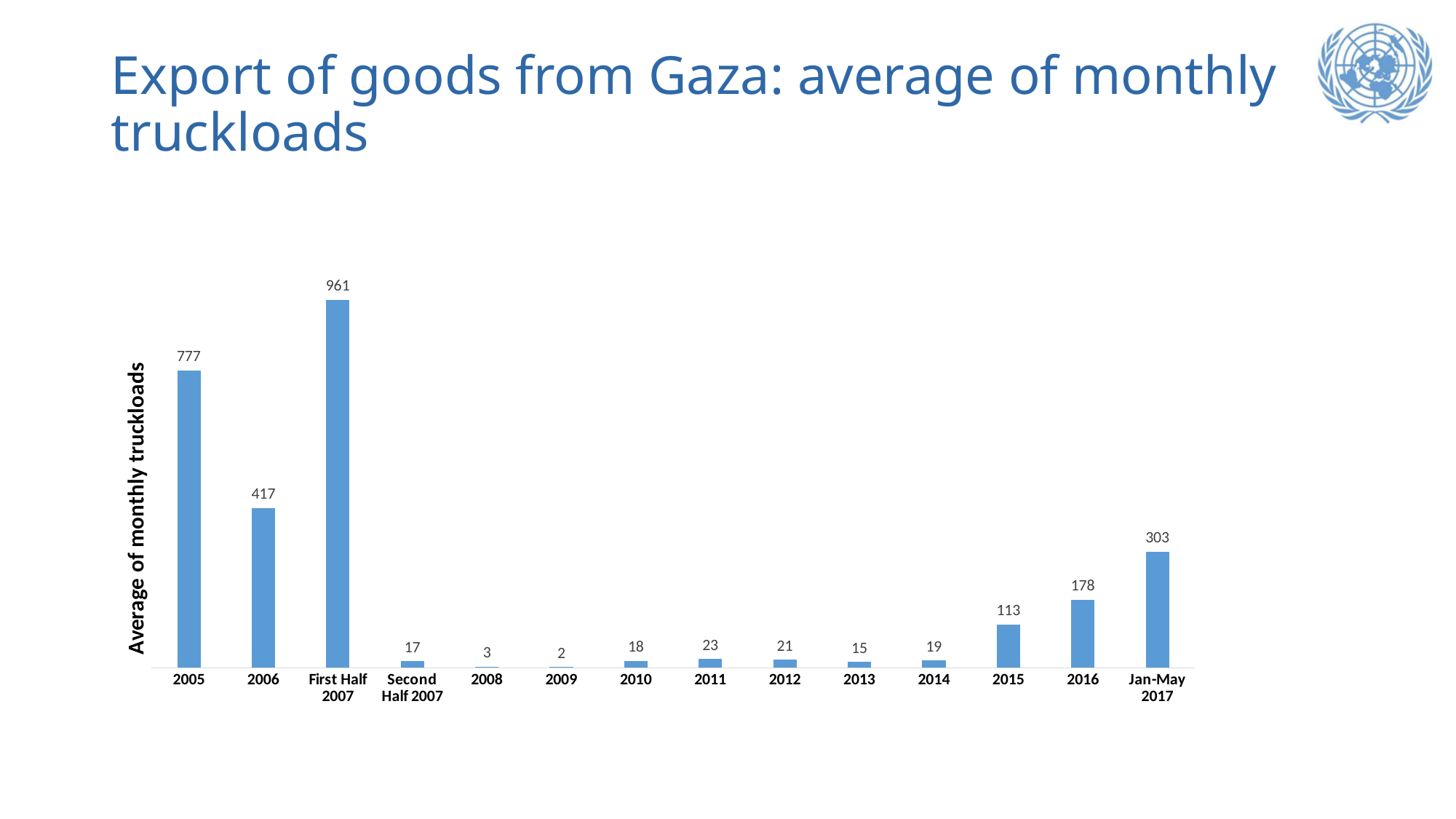
What is the average of monthly truckloads for Jan-May 2017? 303 Do the values rise or fall from 2014 to Jan-May 2017? Rise What kind of chart is shown on the slide? Bar chart Which category has the highest average of monthly truckloads? First Half 2007 Which category has the lowest average of monthly truckloads? 2009 What is the label of the vertical axis of the chart? Average of monthly truckloads What is the difference between the average monthly truckloads in 2016 and 2015? 65 Which is larger, the average monthly truckloads in 2011 or in 2013? 2011 What is the average of monthly truckloads for 2005? 777 What is the average of monthly truckloads for the Second Half 2007? 17 What is the difference between the average monthly truckloads in 2005 and 2006? 360 How many categories are shown on the x axis of the chart? 14